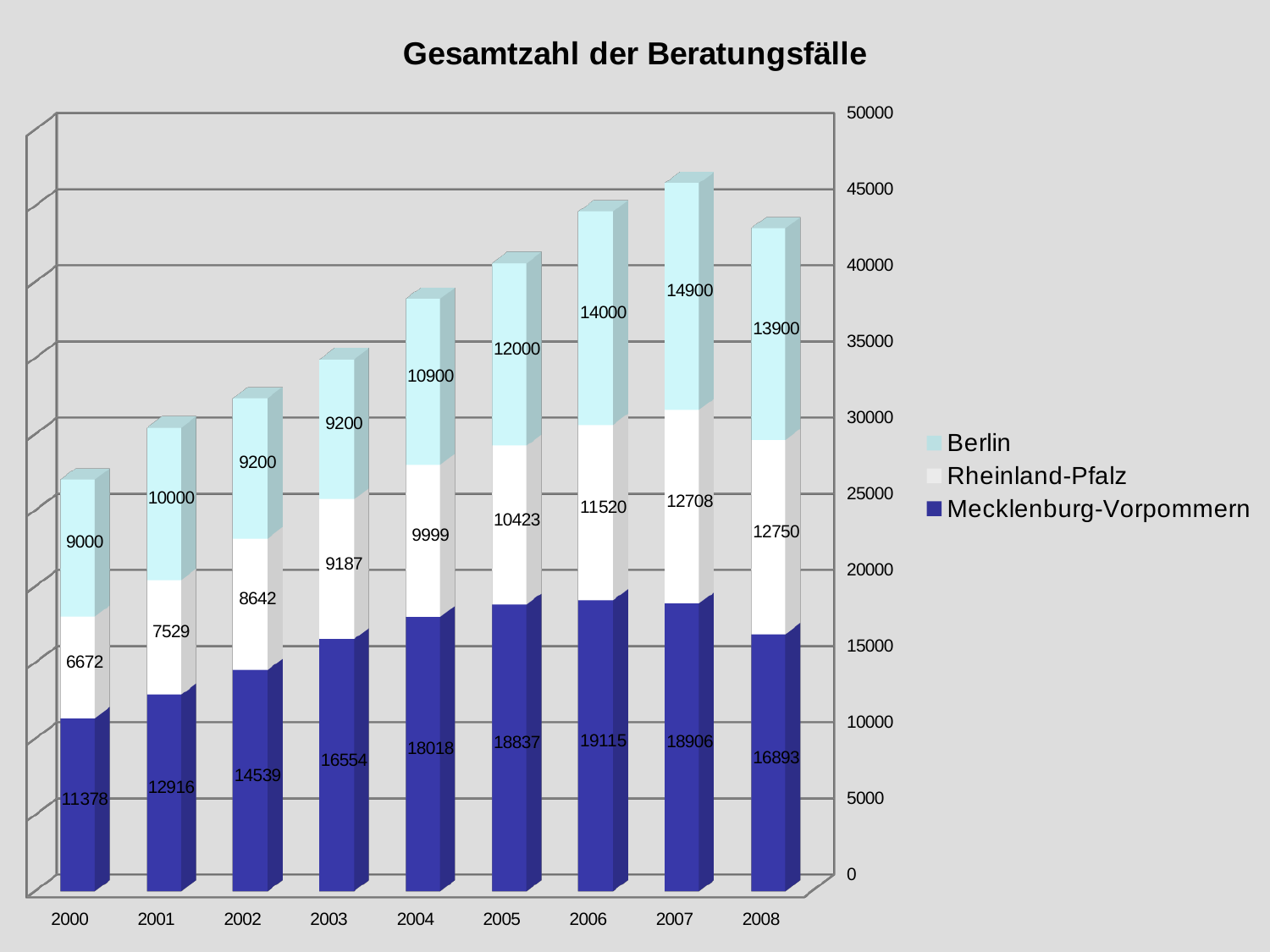
In which year is the Berlin value highest? 2007 What is the total of the stacked bar for 2000? 27050 What is the difference between the Mecklenburg-Vorpommern values in 2006 and 2008? 2222 What is the value for Rheinland-Pfalz in 2007? 12708 What is the value for Mecklenburg-Vorpommern in 2000? 11378 What is the title of the chart? Gesamtzahl der Beratungsfälle How many series does the legend list? 3 Which is larger, the Berlin value in 2005 or the Rheinland-Pfalz value in 2005? Berlin (12000) How many years are shown on the x axis? 9 In which year is the Rheinland-Pfalz value lowest? 2000 What is the value for Berlin in 2004? 10900 What type of chart is shown on the slide? Stacked bar chart